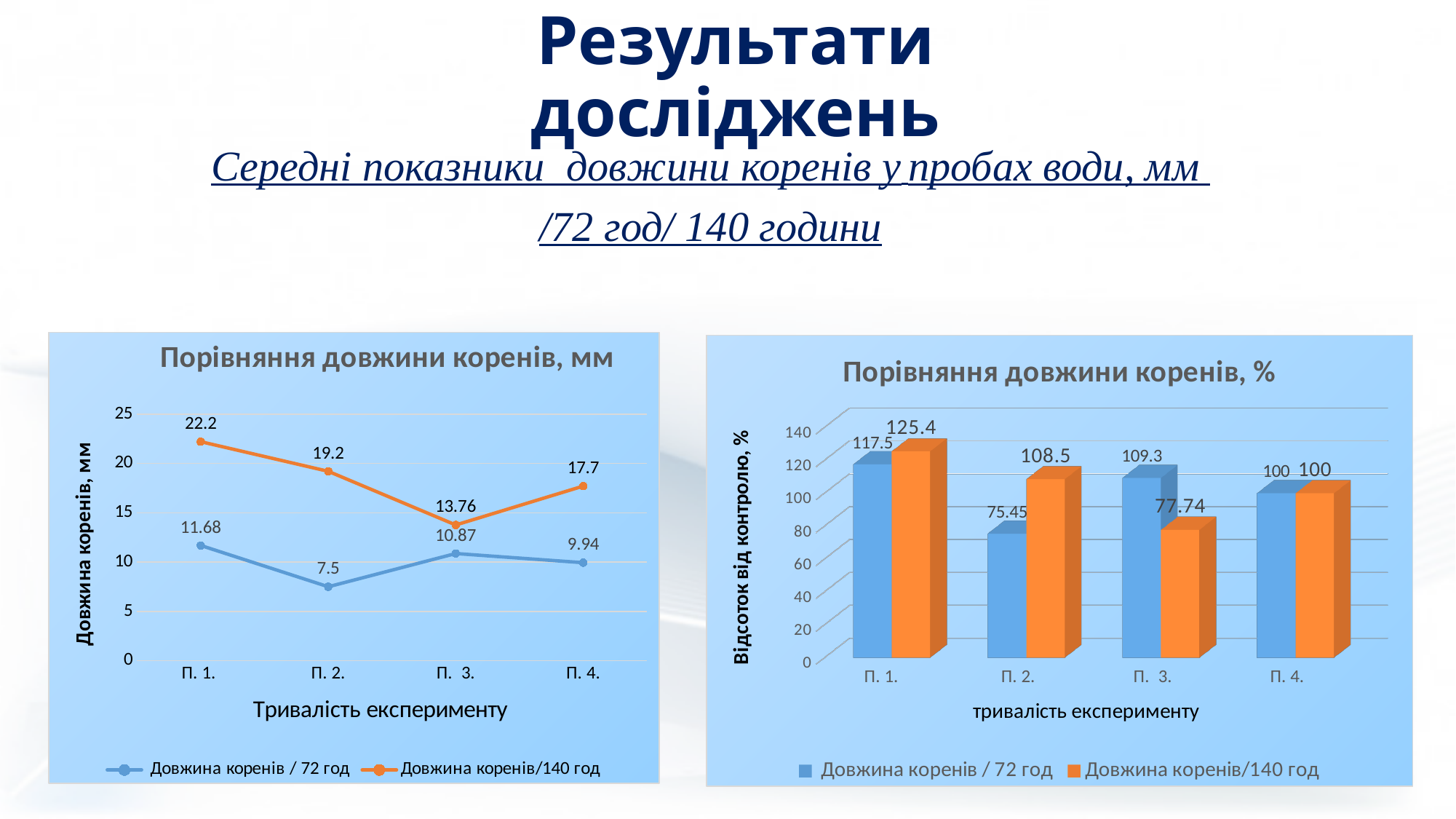
In the chart titled 'Порівняння довжини коренів, мм', what is the value of 'Довжина коренів/140 год' for П. 1.? 22.2 In the chart titled 'Порівняння довжини коренів, мм', what type of chart is shown? Line chart In the chart titled 'Порівняння довжини коренів, мм', what is the difference between the 140 год and 72 год values for П. 1.? 10.52 In the chart titled 'Порівняння довжини коренів, мм', what is the value of 'Довжина коренів / 72 год' for П. 2.? 7.5 In the chart titled 'Порівняння довжини коренів, %', what is the value of 'Довжина коренів/140 год' for П. 3.? 77.74 In the chart titled 'Порівняння довжини коренів, %', how many categories are shown on the x axis? 4 In the chart titled 'Порівняння довжини коренів, %', what is the label of the y axis? Відсоток від контролю, % In the chart titled 'Порівняння довжини коренів, %', which is larger for П. 3.: the 72 год value or the 140 год value? 72 год In the chart titled 'Порівняння довжини коренів, %', what is the value of 'Довжина коренів / 72 год' for П. 2.? 75.45 In the chart titled 'Порівняння довжини коренів, мм', which category has the lowest value for 'Довжина коренів/140 год'? П. 3. In the chart titled 'Порівняння довжини коренів, %', which category has the highest value for 'Довжина коренів/140 год'? П. 1. In the chart titled 'Порівняння довжини коренів, мм', how many series does the legend list? 2